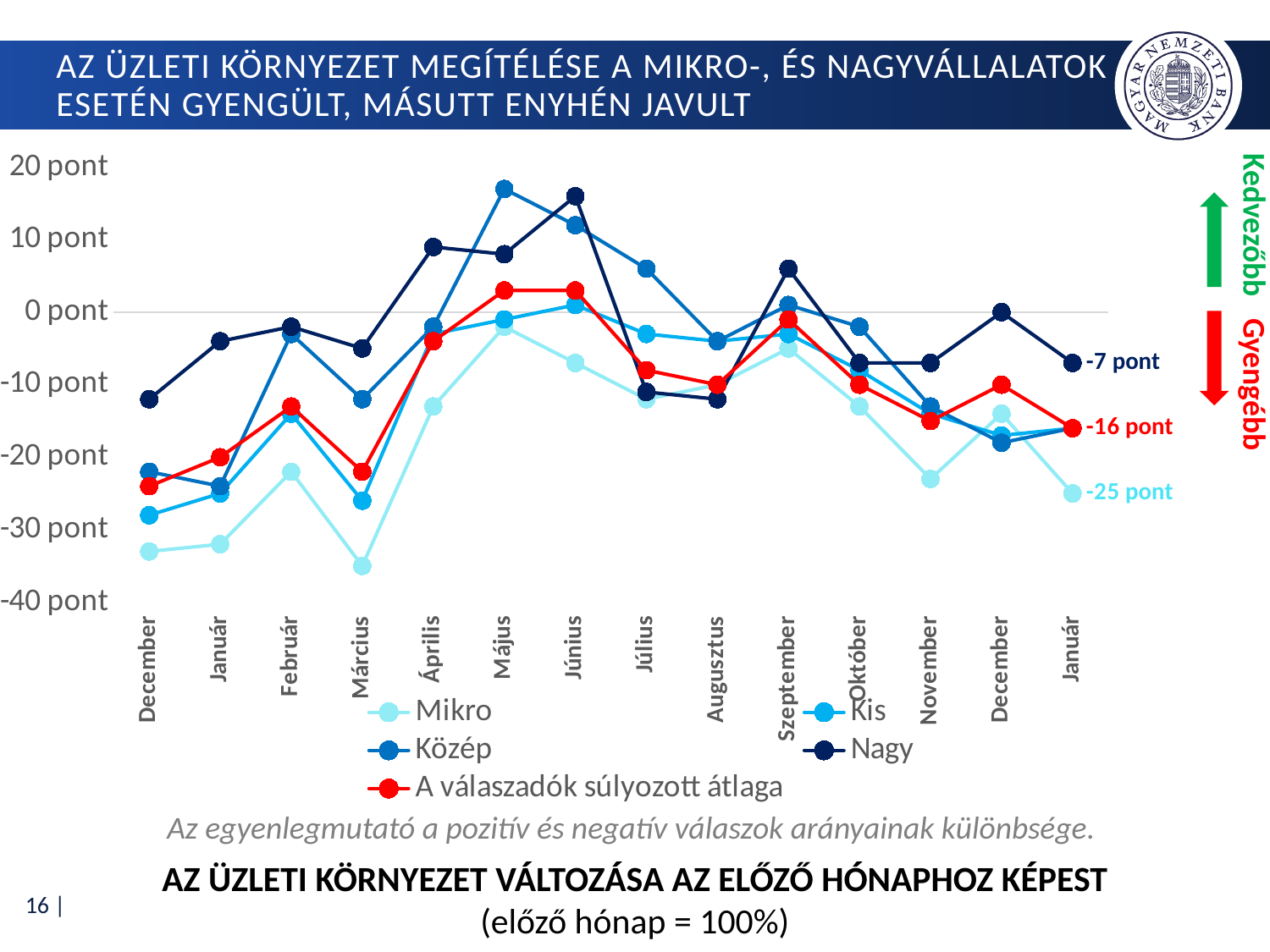
What kind of chart is shown on the slide? line chart In the final Január, which is higher: the Nagy series or the Mikro series? Nagy In the final Január, what is the difference between the Nagy value and the Mikro value? 18 pont Is the Mikro value in Március greater or less than -30 pont? less Which series has the lowest value in Március? Mikro Which series has the highest value in Május? Közép What is the value of the Mikro series in the final Január? -25 pont What is the value of the Nagy series in the final Január? -7 pont How many months are shown along the x axis? 14 Is the Közép value in Május greater or less than 10 pont? greater What is the value of 'A válaszadók súlyozott átlaga' in the final Január? -16 pont How many series does the legend list? 5